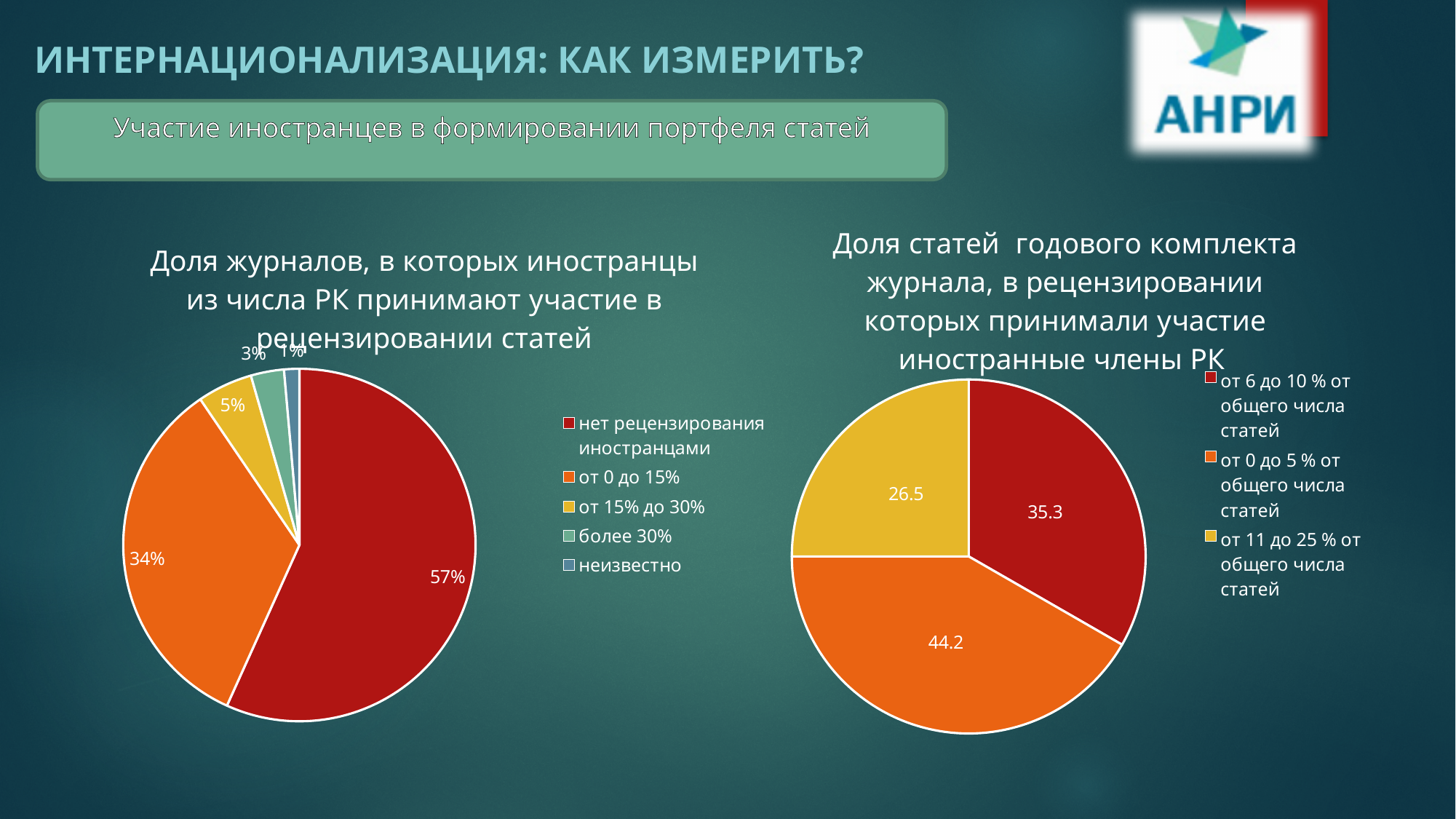
In the left pie chart, what share is labelled for the slice 'более 30%'? 3% In the right pie chart, what value is labelled for the slice 'от 0 до 5 % от общего числа статей'? 44.2 In the right pie chart, which is larger: the 'от 6 до 10 %' slice or the 'от 11 до 25 %' slice? от 6 до 10 % In the left pie chart, what share is labelled for the slice 'от 0 до 15%'? 34% How many entries does the legend of the right pie chart list? 3 In the left pie chart, what share is labelled for the slice 'нет рецензирования иностранцами'? 57% In the right pie chart, which category has the largest slice? от 0 до 5 % от общего числа статей In the right pie chart, what value is labelled for the slice 'от 11 до 25 % от общего числа статей'? 26.5 In the left pie chart, what is the difference between the 'нет рецензирования иностранцами' slice and the 'от 0 до 15%' slice? 23% How many slices does the left pie chart have? 5 In the left pie chart, which category has the smallest slice? неизвестно What type of chart is the left chart on the slide? pie chart